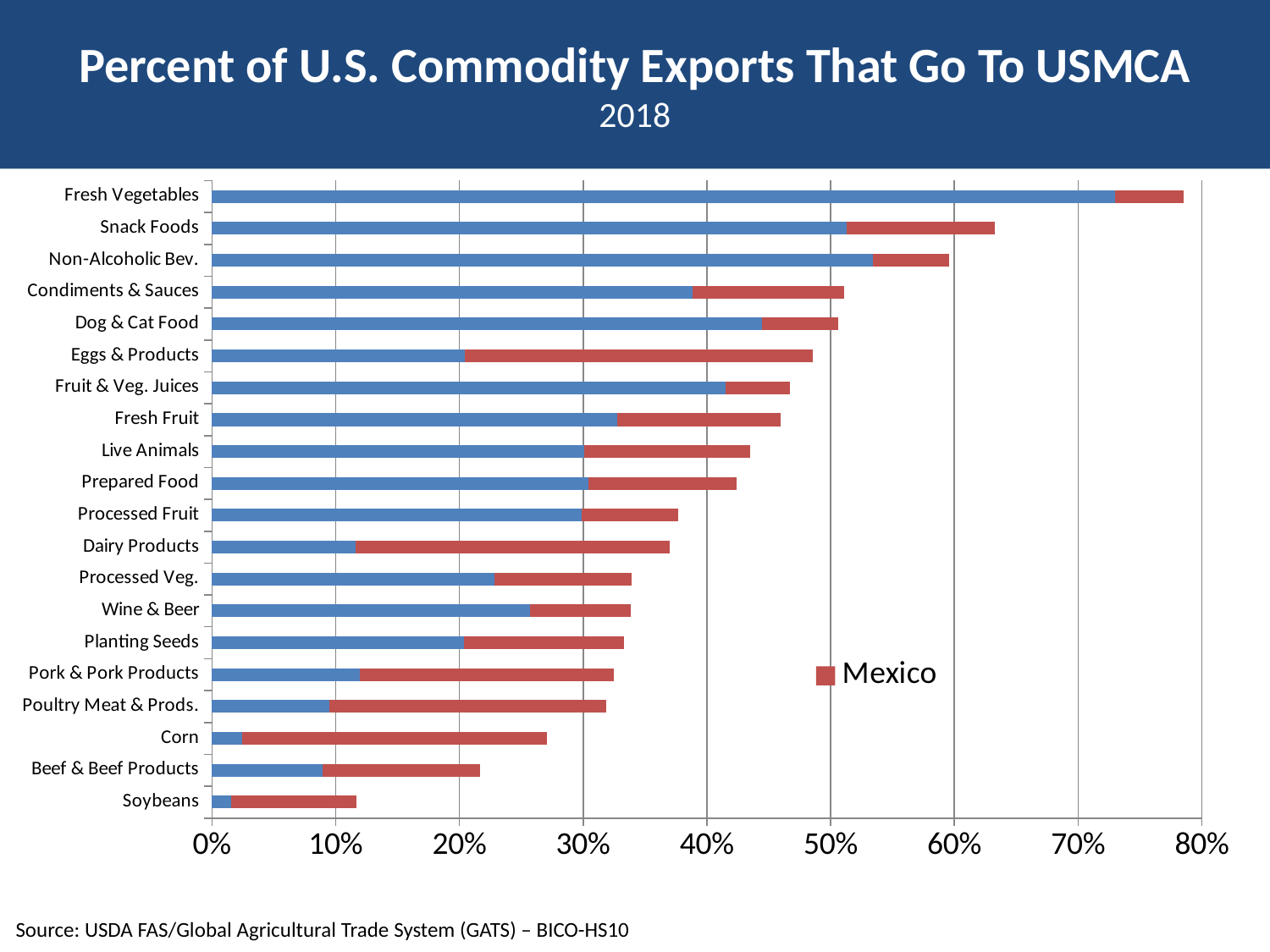
Is the total value for Dairy Products greater or less than 30%? greater How many commodity categories are plotted on the chart? 20 Is the total value for Soybeans greater or less than 20%? less What kind of chart is shown on the slide? Bar chart Which commodity has the lowest total percent of exports going to USMCA? Soybeans Which has a larger total value, Eggs & Products or Dairy Products? Eggs & Products Do the total bar lengths increase or decrease going from the top category to the bottom category? decrease Is the total value for Corn greater or less than 30%? less Which series name is shown in the chart legend? Mexico Which commodity has the highest total percent of exports going to USMCA? Fresh Vegetables